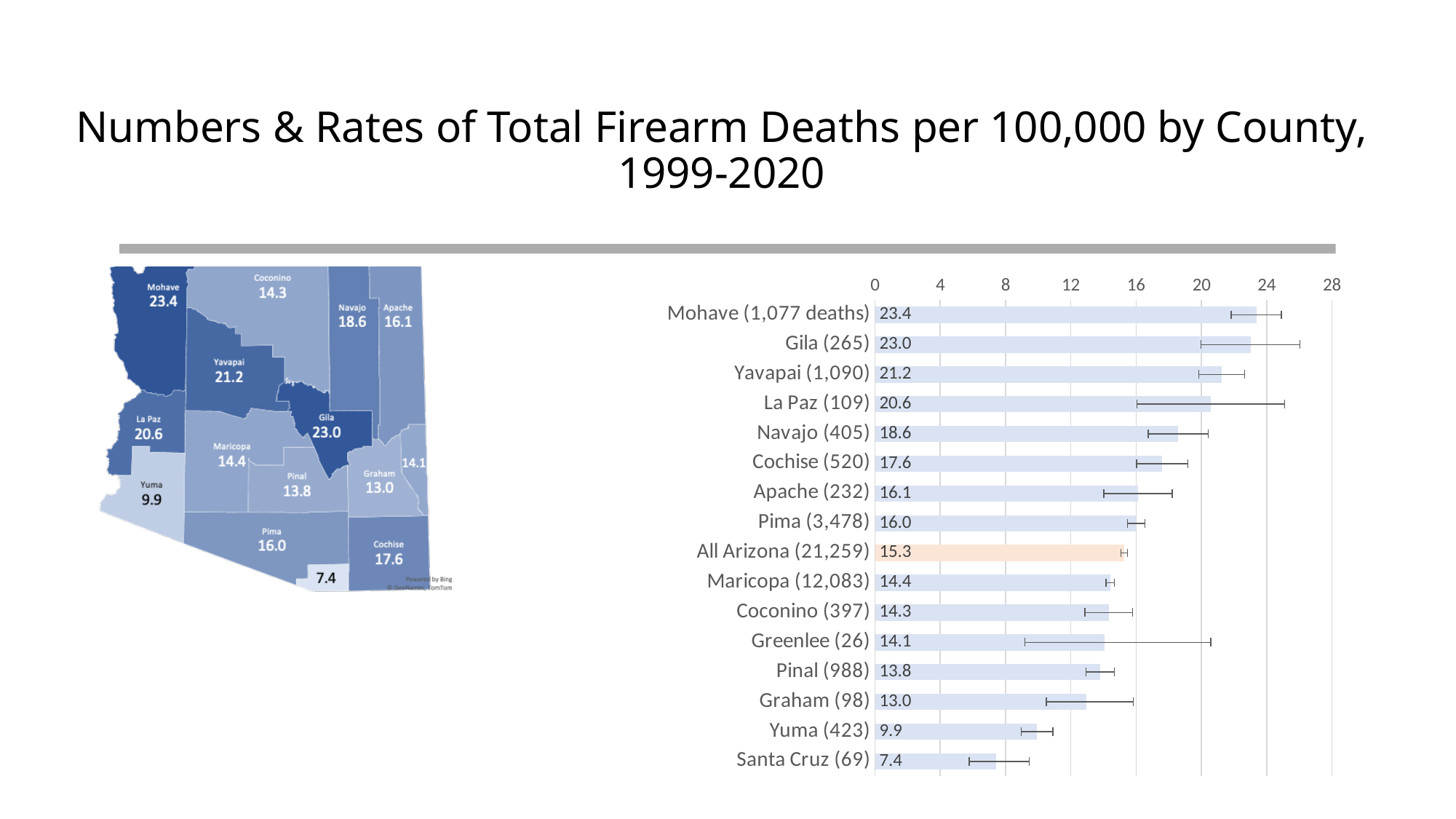
In the bar chart, what is the difference between the rates for Mohave and Gila? 0.4 In the bar chart, is the value for La Paz greater or less than 20? greater In the bar chart, how many deaths are listed in the label for Maricopa? 12,083 In the bar chart, which county has the highest rate? Mohave In the bar chart, which county has the lowest rate? Santa Cruz What kind of chart is shown on the right side of the slide? Bar chart In the bar chart, what is the difference between the rates for Yuma and Santa Cruz? 2.5 In the bar chart, what is the value shown for All Arizona? 15.3 In the bar chart, what is the firearm death rate for Mohave? 23.4 How many bars are shown in the bar chart? 16 In the bar chart, which has a higher rate, Navajo or Cochise? Navajo In the bar chart, what is the value for Santa Cruz? 7.4